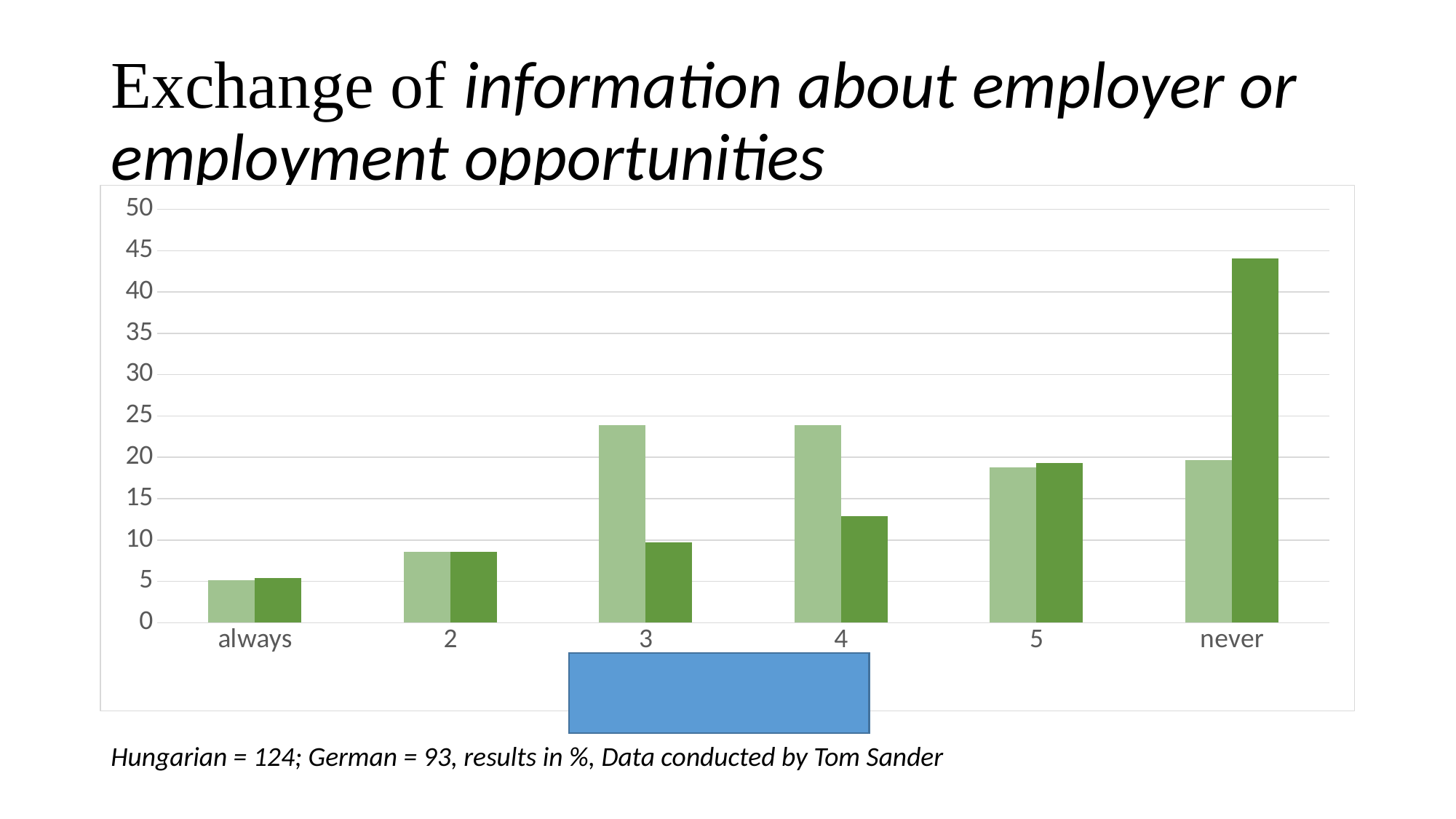
How many categories are shown on the x axis of the chart? 6 Is the value of the light green bar for '5' greater or less than 15? greater What kind of chart is shown on the slide? bar chart Is the value of the dark green bar for 'never' greater or less than 40? greater Is the value of the dark green bar for '2' greater or less than 10? less For which category is the dark green bar the highest? never For the category '4', which bar is larger, the light green or the dark green? light green For which category is the light green bar the lowest? always Which is larger, the dark green bar for 'never' or the dark green bar for '5'? never What is the highest value shown on the y axis of the chart? 50 Do the dark green bars rise or fall from 'always' to 'never' along the x axis? rise